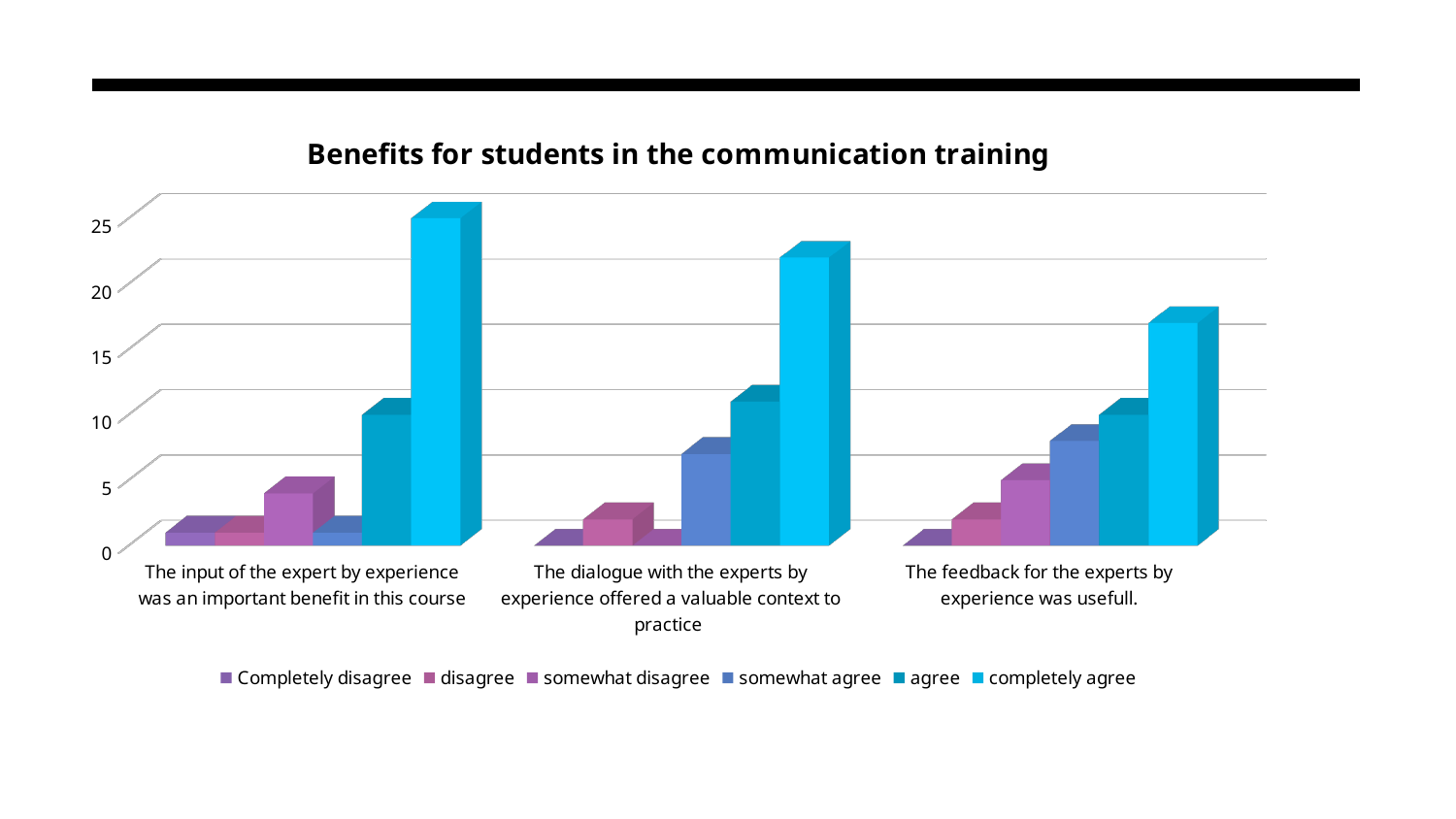
How many series does the legend list? 6 What is the title of the chart? Benefits for students in the communication training How many categories (statements) are shown on the x axis? 3 Which response series has the highest value for 'The input of the expert by experience was an important benefit in this course'? completely agree For which statement is the 'completely agree' bar the lowest? The feedback for the experts by experience was usefull. Is the 'completely agree' value for 'The input of the expert by experience was an important benefit in this course' greater or less than 20? greater For which statement is the 'completely agree' bar the highest? The input of the expert by experience was an important benefit in this course Is the 'completely agree' value for 'The feedback for the experts by experience was usefull.' greater or less than 20? less Is the 'agree' value for 'The input of the expert by experience was an important benefit in this course' greater or less than 15? less Which response series is listed first in the legend? Completely disagree For 'The feedback for the experts by experience was usefull.', which is larger: the 'agree' value or the 'completely agree' value? completely agree What kind of chart is shown on the slide? bar chart